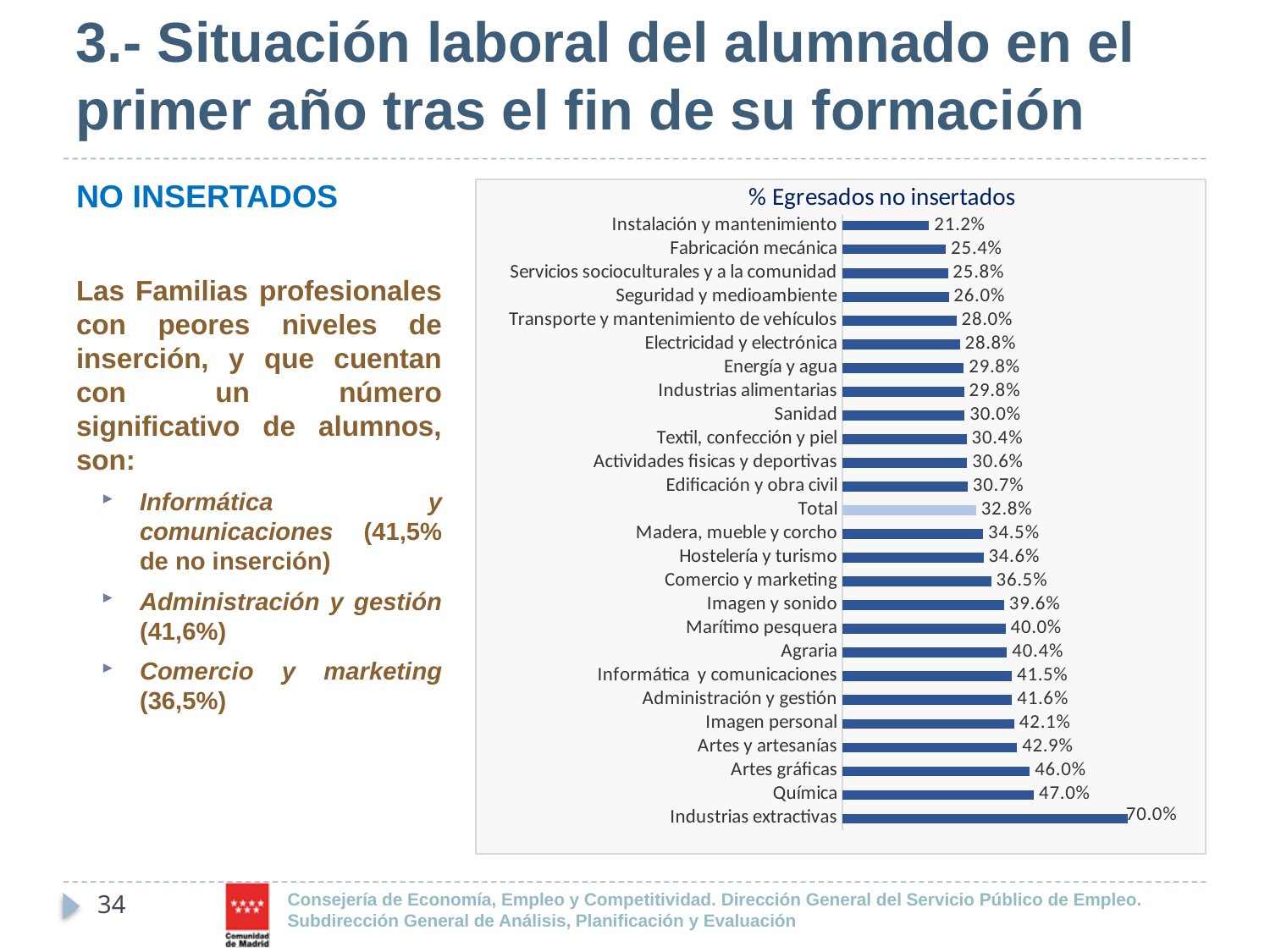
What is the value for Total? 32.8% What kind of chart is shown on the slide? Bar chart Which category has the lowest value? Instalación y mantenimiento Which category has the highest value? Industrias extractivas What is the difference between the values for Química and Artes gráficas? 1.0% What is the difference between the values for Industrias extractivas and Total? 37.2% What is the title of the chart? % Egresados no insertados Which is larger, the value for Comercio y marketing or the value for Madera, mueble y corcho? Comercio y marketing What is the value for Informática y comunicaciones? 41.5% What is the value for Hostelería y turismo? 34.6% What is the value for Industrias extractivas? 70.0% How many bars are plotted in the chart, including Total? 26